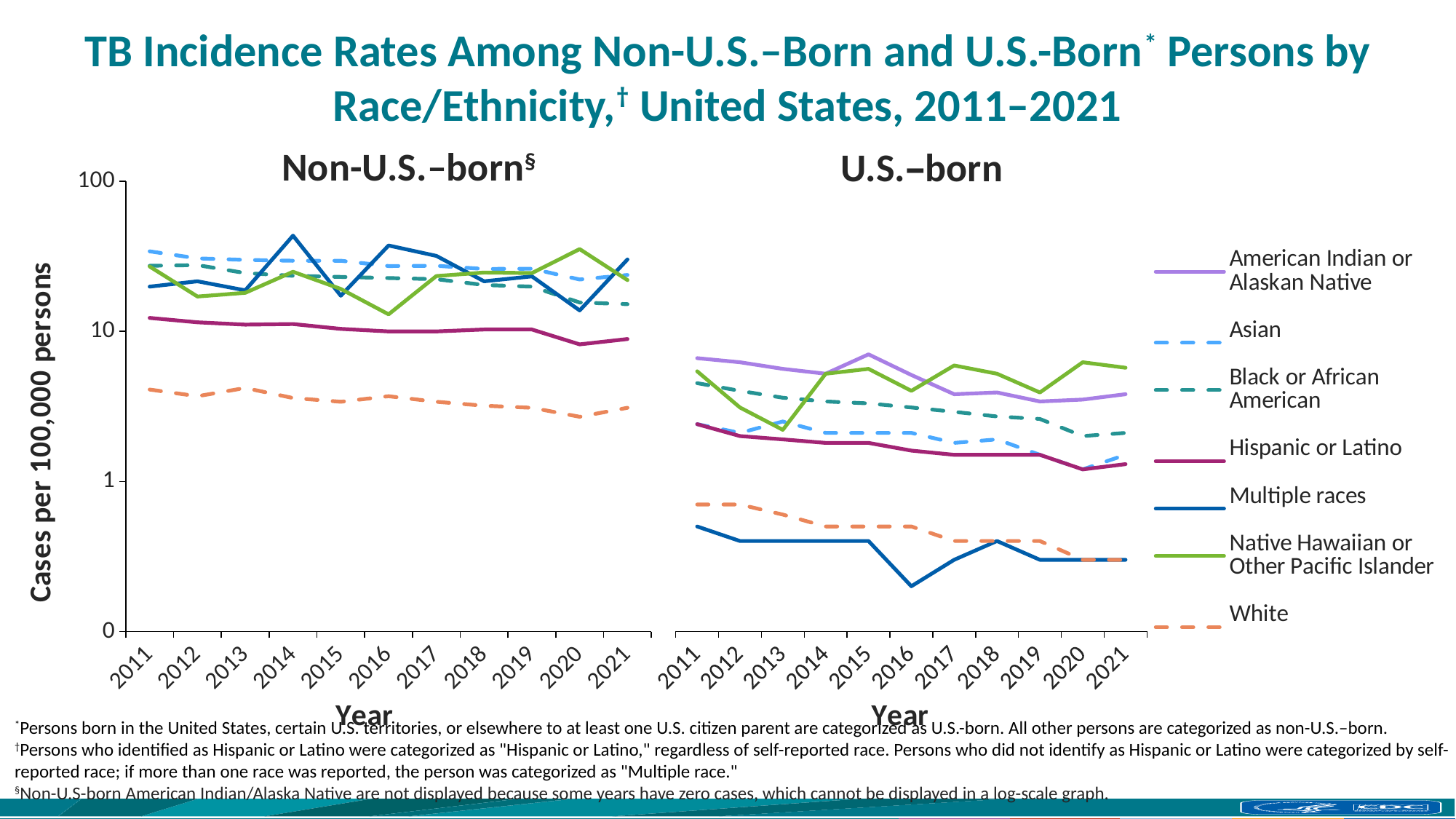
In the U.S.-born chart, is the value for White in 2011 greater or less than 1? less In the Non-U.S.-born chart, is the value for Asian in 2011 greater or less than 10? greater How many series does the legend list? 7 How many years are shown on the x axis of the U.S.-born chart? 11 In the Non-U.S.-born chart, which is larger in 2011: Hispanic or Latino or White? Hispanic or Latino In the Non-U.S.-born chart, which series has the lowest value in 2011? White In the U.S.-born chart, is the value for Multiple races in 2016 greater or less than 1? less In the U.S.-born chart, does the White series rise or fall from 2011 to 2021? Fall In the U.S.-born chart, which series has the highest value in 2011? American Indian or Alaskan Native What is the label on the y axis? Cases per 100,000 persons What kind of chart is the Non-U.S.-born chart? Line chart